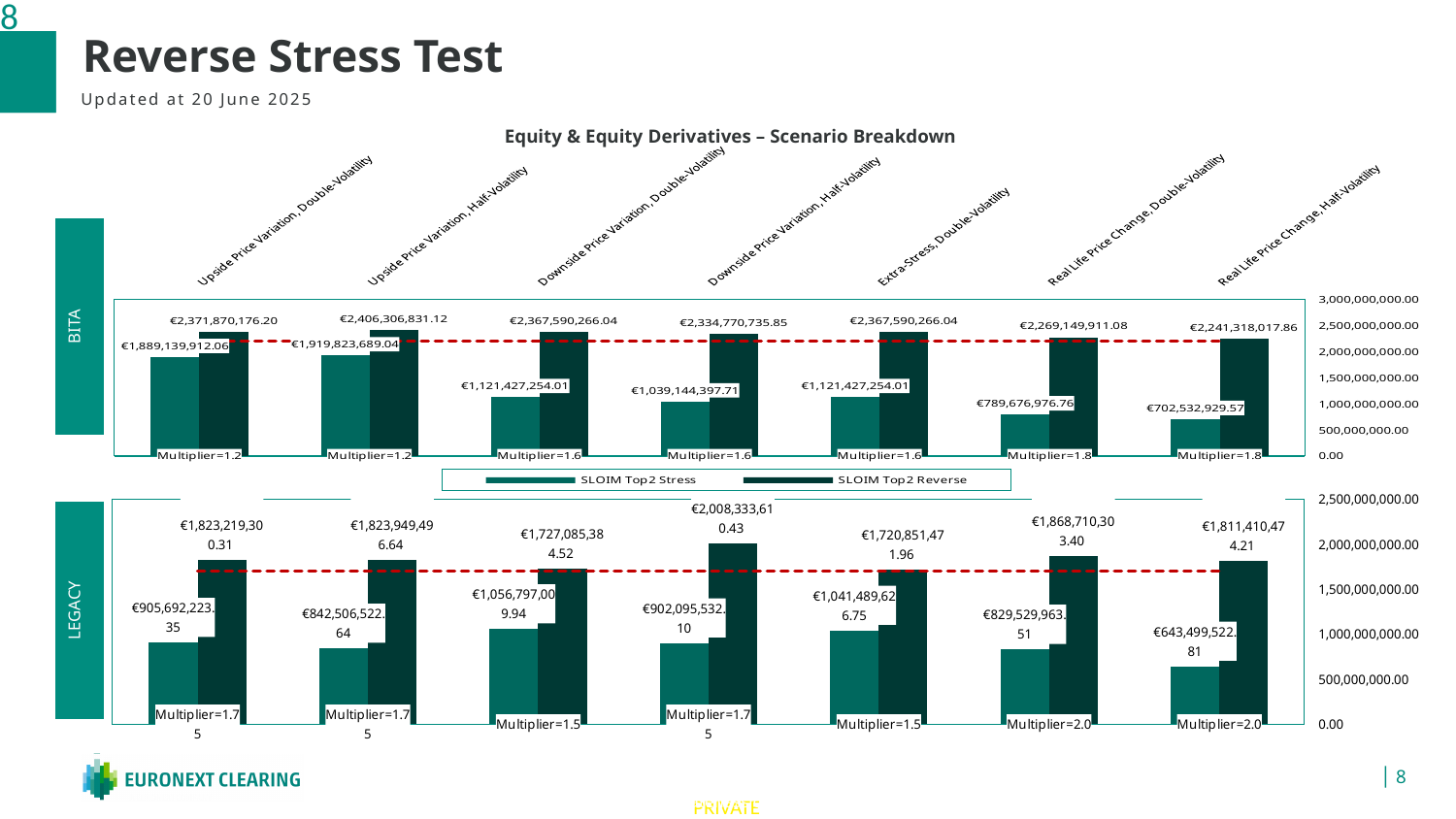
In the BITA chart, what is the SLOIM Top2 Reverse value for Upside Price Variation, Half-Volatility? €2,406,306,831.12 How many scenario categories are shown in the BITA chart? 7 In the LEGACY chart, which is larger: the SLOIM Top2 Stress value for Downside Price Variation, Double-Volatility or for Upside Price Variation, Half-Volatility? Downside Price Variation, Double-Volatility In the BITA chart, which scenario has the highest SLOIM Top2 Reverse value? Upside Price Variation, Half-Volatility How many series does the legend list? 2 In the LEGACY chart, is the SLOIM Top2 Stress value for Real Life Price Change, Half-Volatility greater or less than 1,000,000,000.00? less In the BITA chart, what is the difference between the SLOIM Top2 Reverse and SLOIM Top2 Stress values for Downside Price Variation, Half-Volatility? €1,295,626,338.14 In the BITA chart, what is the SLOIM Top2 Stress value for Upside Price Variation, Double-Volatility? €1,889,139,912.06 In the BITA chart, which scenario has the lowest SLOIM Top2 Stress value? Real Life Price Change, Half-Volatility In the LEGACY chart, what multiplier is shown for Extra-Stress, Double-Volatility? Multiplier=1.5 In the BITA chart, what multiplier is shown for Real Life Price Change, Double-Volatility? Multiplier=1.8 In the BITA chart, what is the SLOIM Top2 Stress value for Real Life Price Change, Half-Volatility? €702,532,929.57